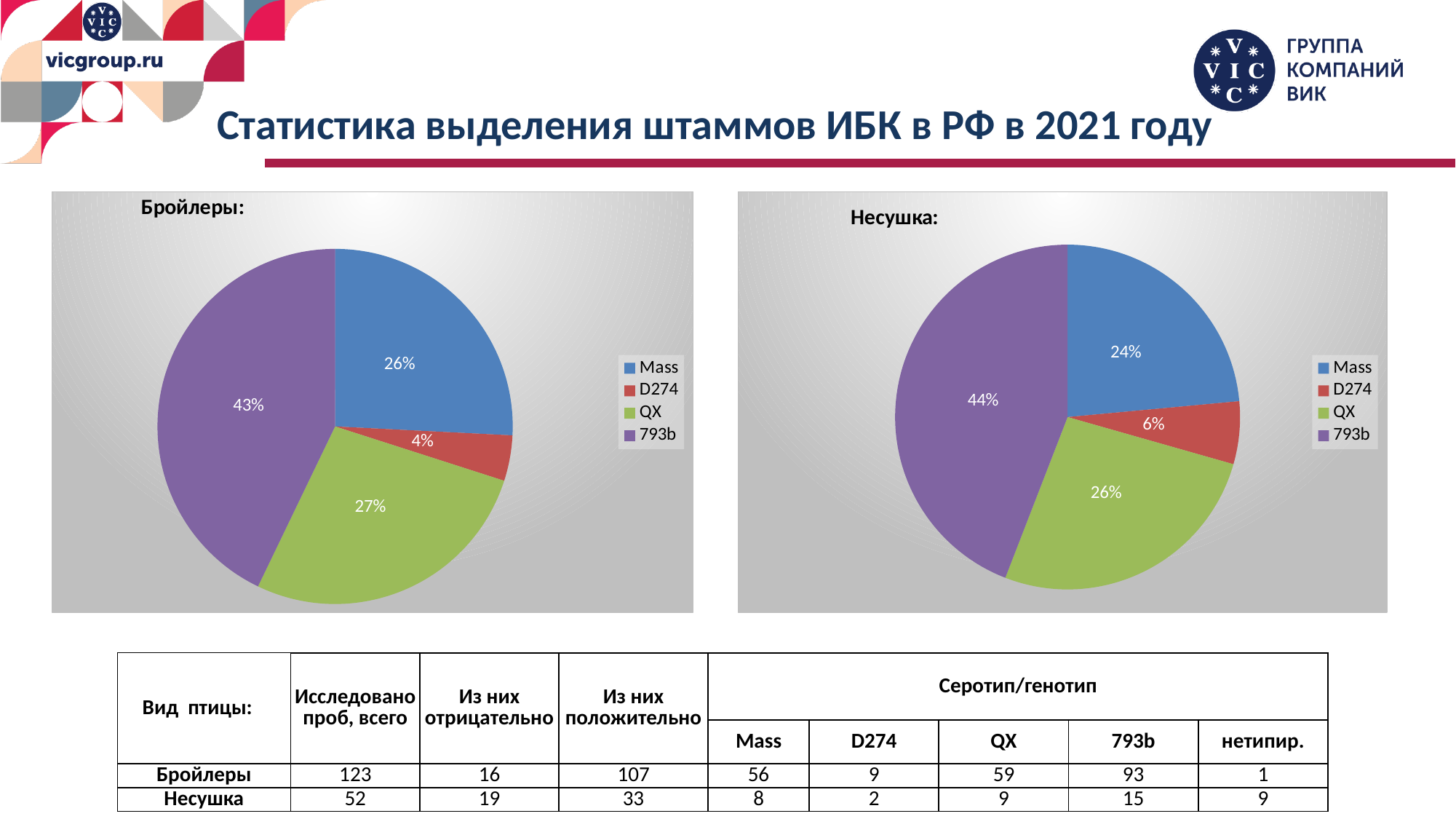
In the "Несушка:" pie chart, which category has the smallest slice? D274 How many entries does the legend of the "Несушка:" chart list? 4 In the "Несушка:" pie chart, what share does Mass have? 24% In the "Бройлеры:" pie chart, which colour represents QX? Green In the "Бройлеры:" pie chart, which category has the largest slice? 793b What type of chart is the "Несушка:" chart? Pie chart In the "Бройлеры:" pie chart, what is the difference in percentage points between 793b and QX? 16 In the "Бройлеры:" pie chart, what share does 793b have? 43% In the "Несушка:" pie chart, what share does QX have? 26% How many slices does the "Бройлеры:" pie chart have? 4 In the "Бройлеры:" pie chart, what share does D274 have? 4% In the "Несушка:" pie chart, which is larger, the Mass slice or the QX slice? QX